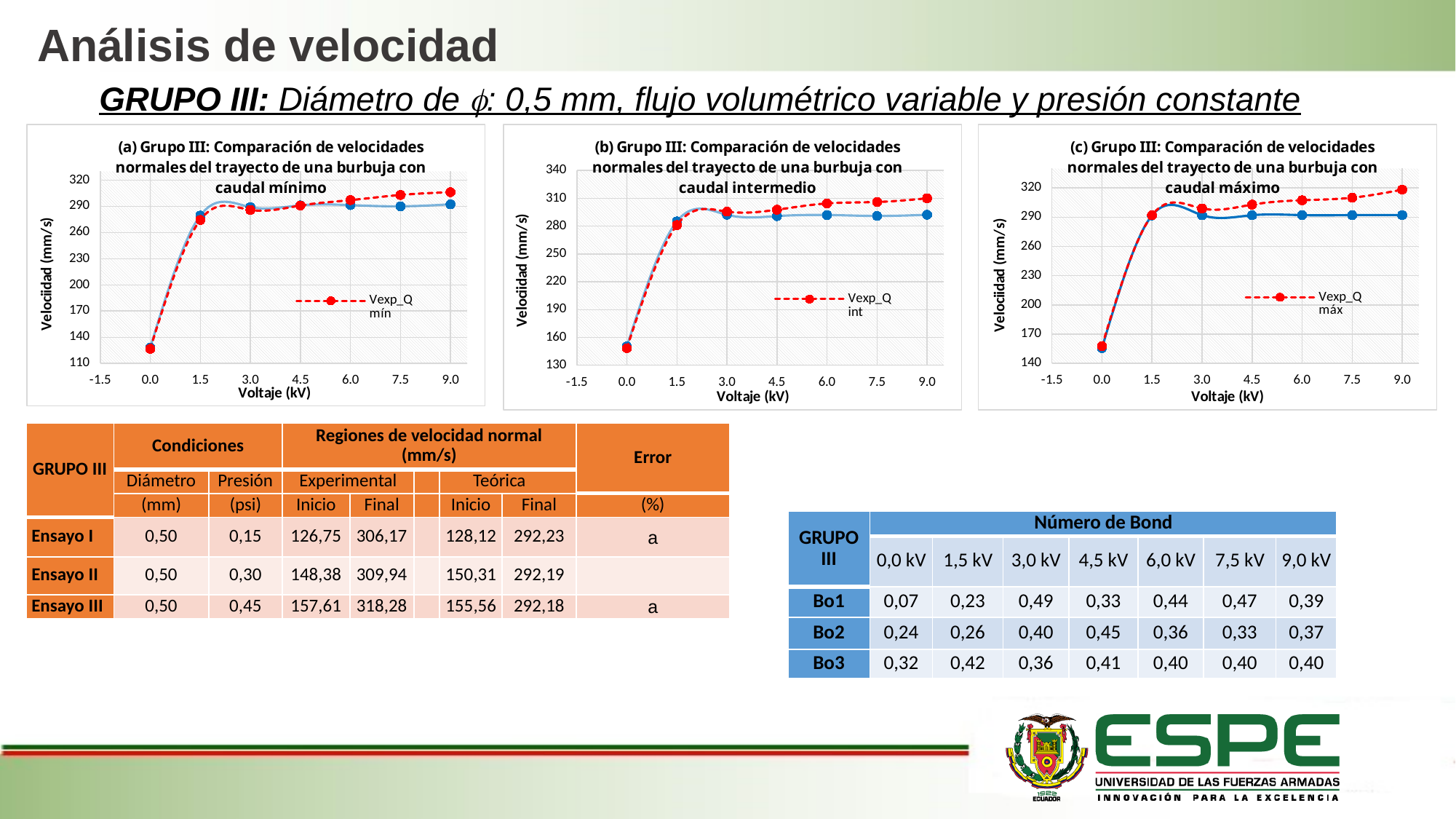
In chart (c) (caudal máximo), do the Vexp_Q máx values rise or fall from 0.0 kV to 9.0 kV? rise What kind of chart is chart (a), 'Grupo III: Comparación de velocidades normales del trayecto de una burbuja con caudal mínimo'? line chart In chart (b) (caudal intermedio), which voltage has the lowest Vexp_Q int value? 0.0 In chart (a) (caudal mínimo), how many data points are plotted along the voltage axis for the Vexp_Q mín series? 7 In chart (b) (caudal intermedio), is the Vexp_Q int value at 9.0 kV greater or less than 280? greater In chart (a) (caudal mínimo), is the Vexp_Q mín value at 9.0 kV greater or less than 290? greater In chart (b) (caudal intermedio), is the Vexp_Q int value at 0.0 kV greater or less than 160? less What is the label of the x axis in chart (a) (caudal mínimo)? Voltaje (kV) What legend entry is shown in chart (c), the rightmost chart? Vexp_Q máx